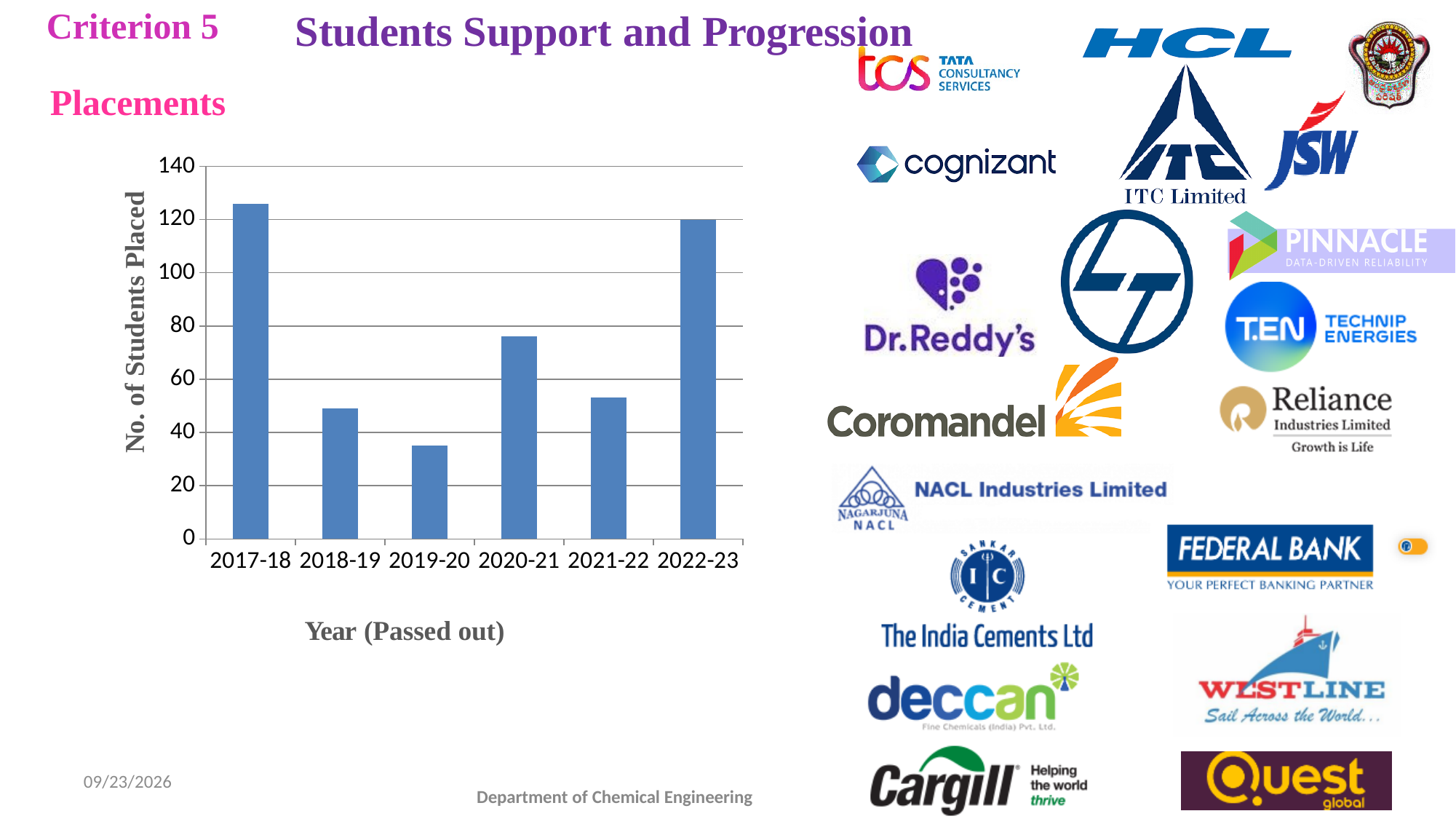
Which year had more students placed, 2020-21 or 2021-22? 2020-21 What is the label of the x axis of the chart? Year (Passed out) Is the number of students placed in 2018-19 greater or less than 60? less Is the number of students placed in 2020-21 greater or less than 60? greater What kind of chart is shown on the slide? bar chart Is the number of students placed in 2019-20 greater or less than 40? less Which year has the highest number of students placed? 2017-18 Which year has the lowest number of students placed? 2019-20 What is the label of the y axis of the chart? No. of Students Placed How many years are shown on the x axis of the chart? 6